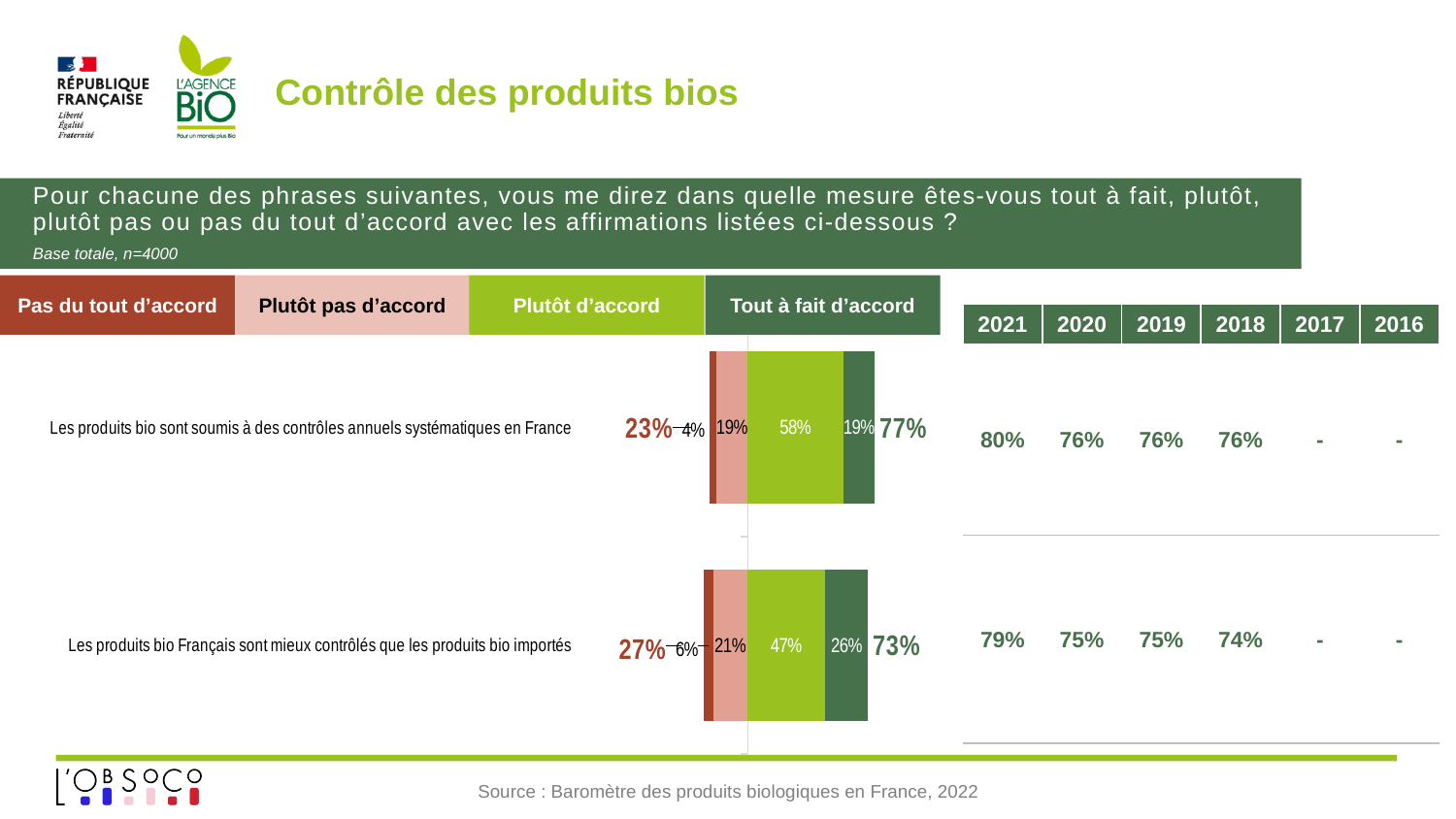
What is the total disagreement shown for the statement "Les produits bio Français sont mieux contrôlés que les produits bio importés"? 27% Which statement has the higher "Tout à fait d'accord" share? Les produits bio Français sont mieux contrôlés que les produits bio importés What percentage of respondents answered "Tout à fait d'accord" for the statement "Les produits bio Français sont mieux contrôlés que les produits bio importés"? 26% Which colour represents "Tout à fait d'accord" in the legend? Dark green What percentage of respondents answered "Plutôt d'accord" for the statement "Les produits bio sont soumis à des contrôles annuels systématiques en France"? 58% How many statements are plotted in the chart? 2 How many response categories does the legend list? 4 What type of chart is used to show the responses? Stacked bar chart In the table on the right, what was the agreement score in 2021 for "Les produits bio sont soumis à des contrôles annuels systématiques en France"? 80% What is the total agreement (Plutôt d'accord + Tout à fait d'accord) shown for the statement "Les produits bio sont soumis à des contrôles annuels systématiques en France"? 77% What is the "Pas du tout d'accord" share for the statement "Les produits bio Français sont mieux contrôlés que les produits bio importés"? 6% What is the difference between the "Plutôt d'accord" shares of the two statements? 11 points